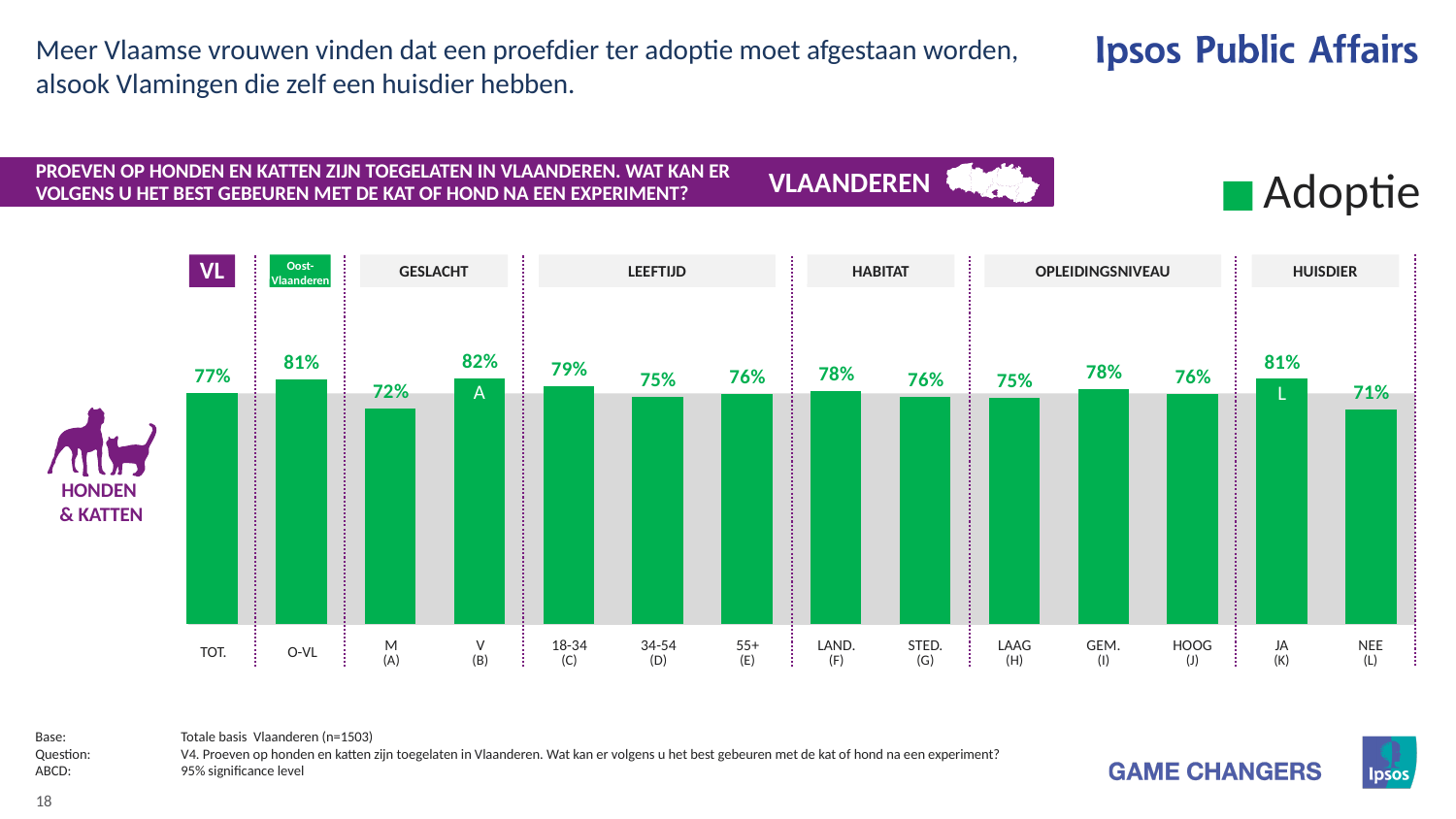
What is the value for 18-34 (C)? 79% Which category has the lowest value? NEE (L) What is the value for NEE (L) in the HUISDIER group? 71% How many bars are plotted in the chart? 14 What is the difference between the values for JA (K) and NEE (L)? 10% What is the difference between the values for V (B) and M (A)? 10% What is the value for V (B) in the GESLACHT group? 82% What is the value for TOT.? 77% How many series does the legend list? 1 Which is larger, the value for LAND. (F) or STED. (G)? LAND. (F) Which category has the highest value? V (B) What kind of chart is shown on the slide? Bar chart